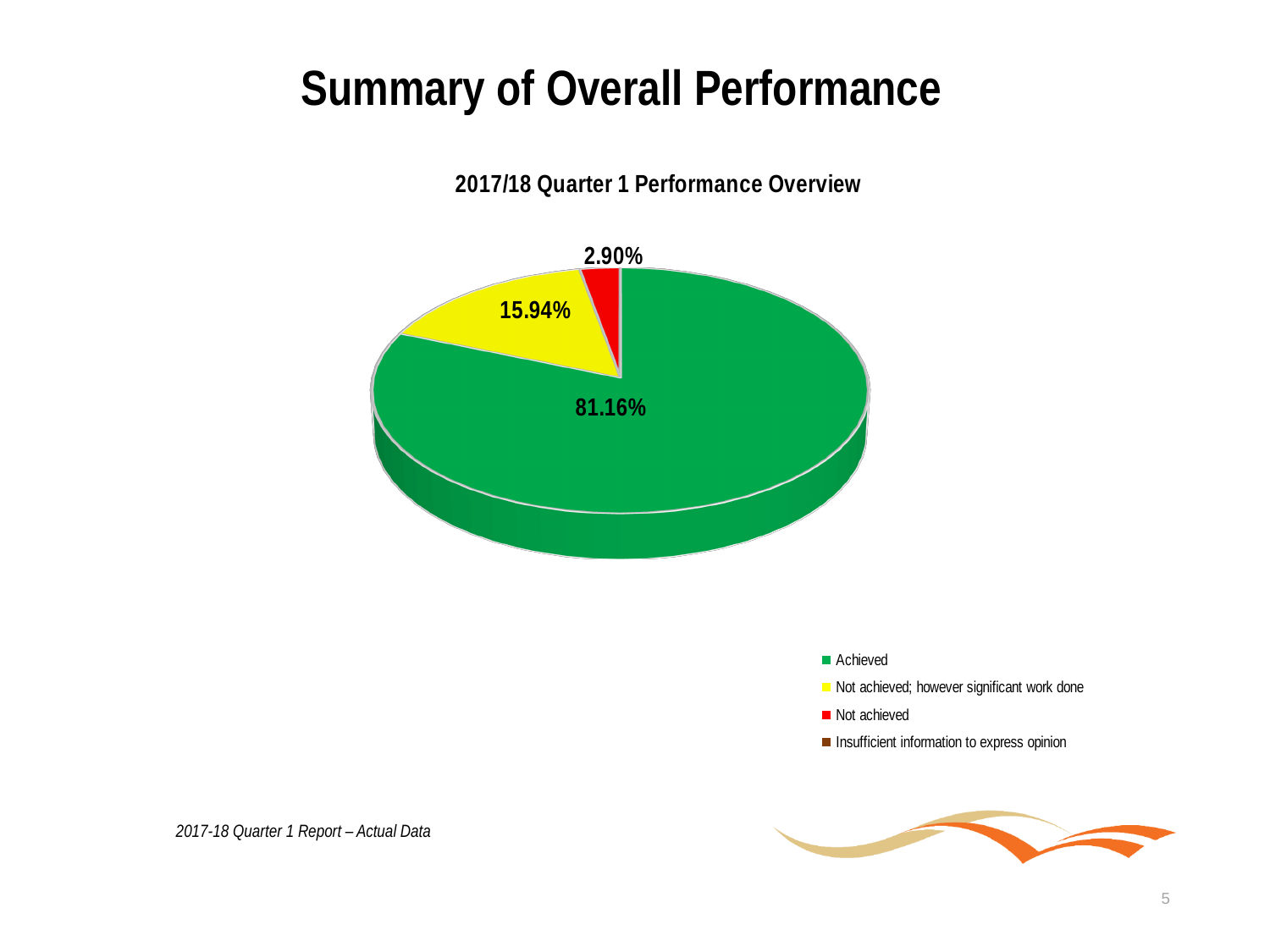
Which category has the largest share of the pie? Achieved Which category with a visible slice has the smallest share of the pie? Not achieved What is the difference between the Achieved share and the 'Not achieved; however significant work done' share? 65.22% What percentage of the pie is labelled for the Achieved category? 81.16% What colour represents the Achieved category? Green What percentage is shown for the 'Not achieved' category? 2.90% Which is larger: the 'Not achieved; however significant work done' share or the 'Not achieved' share? Not achieved; however significant work done How many categories does the legend list? 4 What percentage is shown for the 'Not achieved; however significant work done' category? 15.94% What is the title of the chart? 2017/18 Quarter 1 Performance Overview What type of chart is shown on the slide? Pie chart What is the combined share of the two 'Not achieved' categories (with and without significant work done)? 18.84%